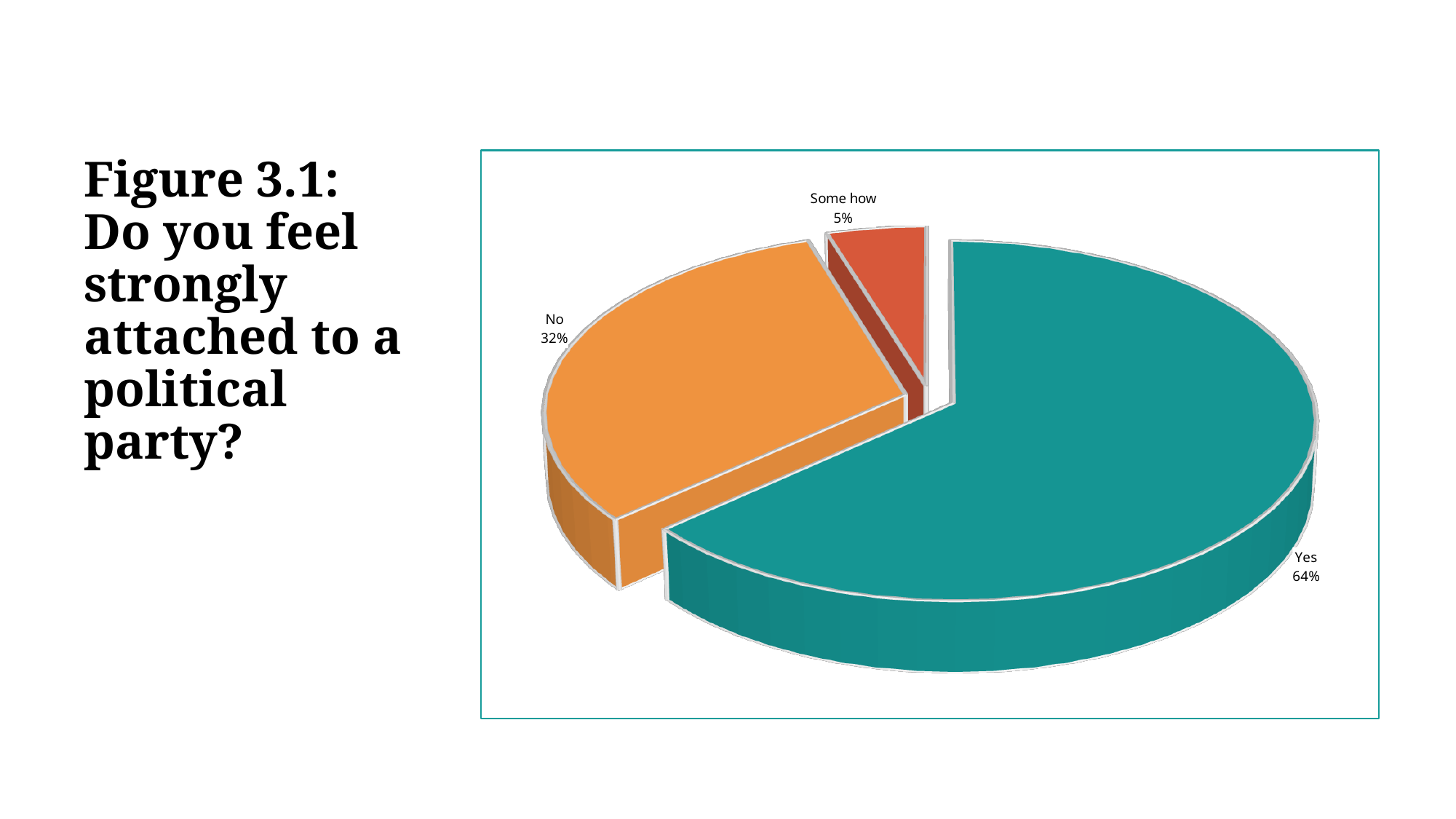
How many slices does the pie chart have? 3 What percentage of respondents answered "No"? 32% Which response has the largest share of the pie? Yes What is the difference in percentage points between the "No" and "Some how" slices? 27 What percentage of respondents answered "Yes"? 64% Which response has the smallest share of the pie? Some how What colour is the "Yes" slice? Teal What percentage of respondents answered "Some how"? 5% Which slice is larger, "No" or "Some how"? No What kind of chart is shown on the slide? Pie chart What is the difference in percentage points between the "Yes" and "No" slices? 32 What question does the figure title say the chart is about? Do you feel strongly attached to a political party?